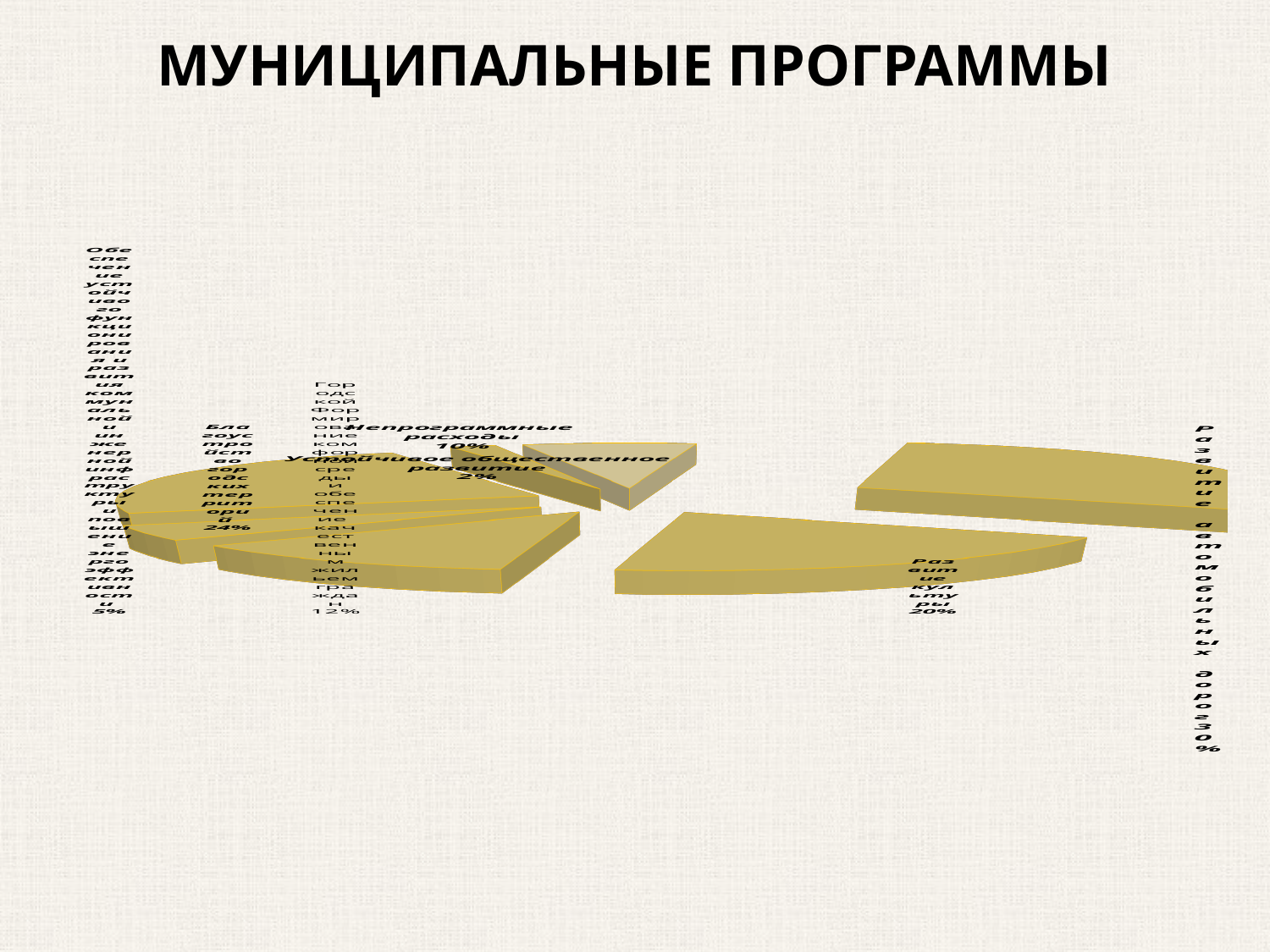
What share of the pie does "Благоустройство городских территорий" take? 24% What is the title of the slide containing the pie chart? МУНИЦИПАЛЬНЫЕ ПРОГРАММЫ Which is larger: the share for "Непрограммные расходы" or the share for "Развитие культуры"? Развитие культуры What share of the pie does "Устойчивое общественное развитие" take? 2% What share of the pie does "Непрограммные расходы" take? 10% What is the difference in percentage points between "Развитие автомобильных дорог" and "Развитие культуры"? 10 Which slice of the pie chart is the largest? Развитие автомобильных дорог Which slice of the pie chart is the smallest? Устойчивое общественное развитие What kind of chart is shown on the slide? pie chart What is the difference in percentage points between "Благоустройство городских территорий" and "Непрограммные расходы"? 14